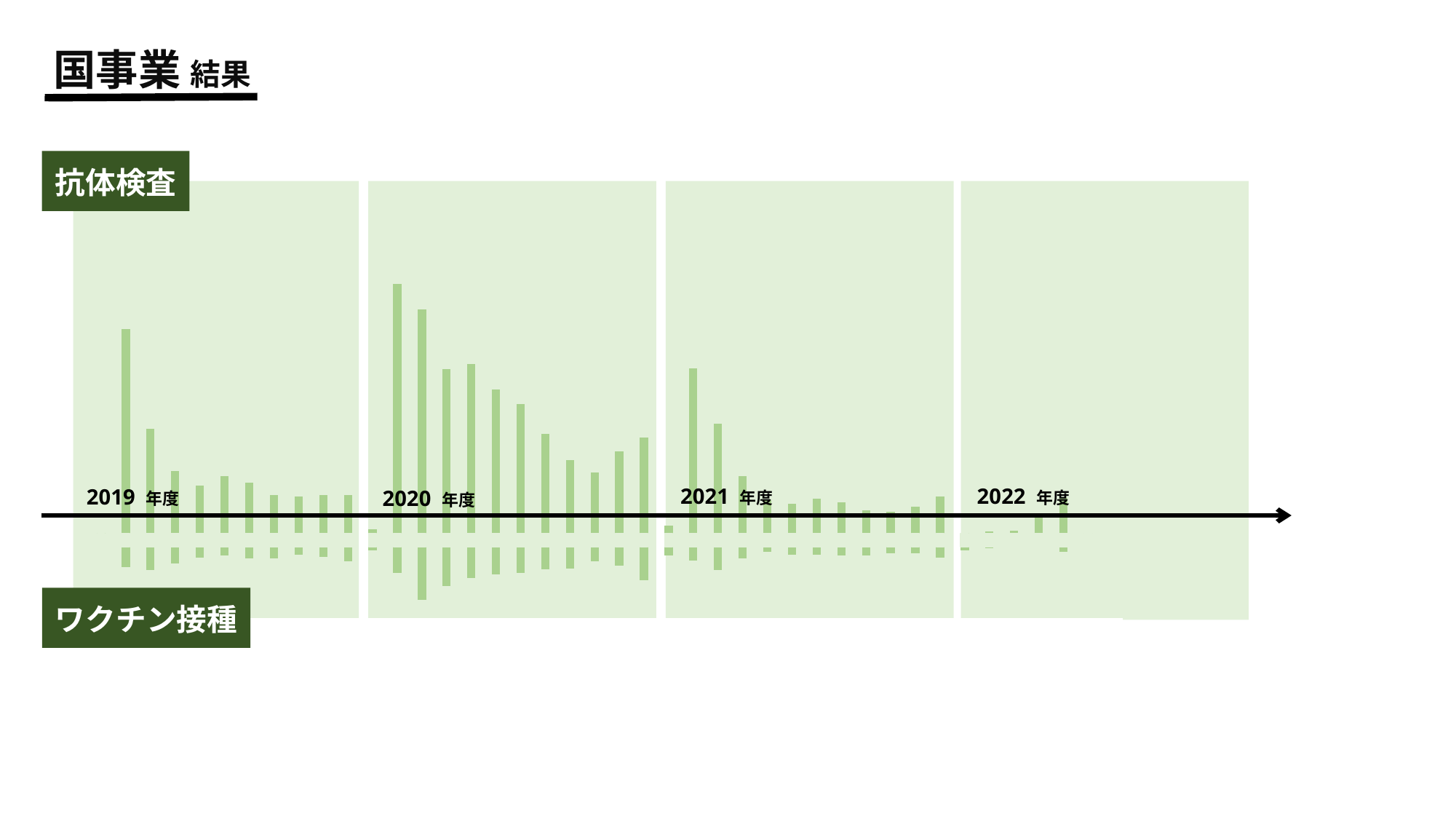
Within 2020 年度, do the 抗体検査 bars generally rise or fall from left to right? fall Which fiscal year has the smallest 抗体検査 bars overall? 2022 年度 Is the tallest 抗体検査 bar in 2019 年度 taller or shorter than the tallest 抗体検査 bar in 2021 年度? taller What is the title of the slide containing the chart? 国事業 結果 Which fiscal year contains the longest ワクチン接種 bar below the timeline? 2020 年度 What does the label above the timeline say the upward bars represent? 抗体検査 Which fiscal year contains the tallest 抗体検査 bar? 2020 年度 From 2020 年度 to 2022 年度, do the 抗体検査 bars generally rise or fall? fall Is the tallest 抗体検査 bar in 2019 年度 taller or shorter than the tallest 抗体検査 bar in 2020 年度? shorter What kind of chart is shown on the slide? bar chart How many fiscal years are labelled along the timeline of the chart? 4 Within 2019 年度, do the 抗体検査 bars generally rise or fall from left to right? fall